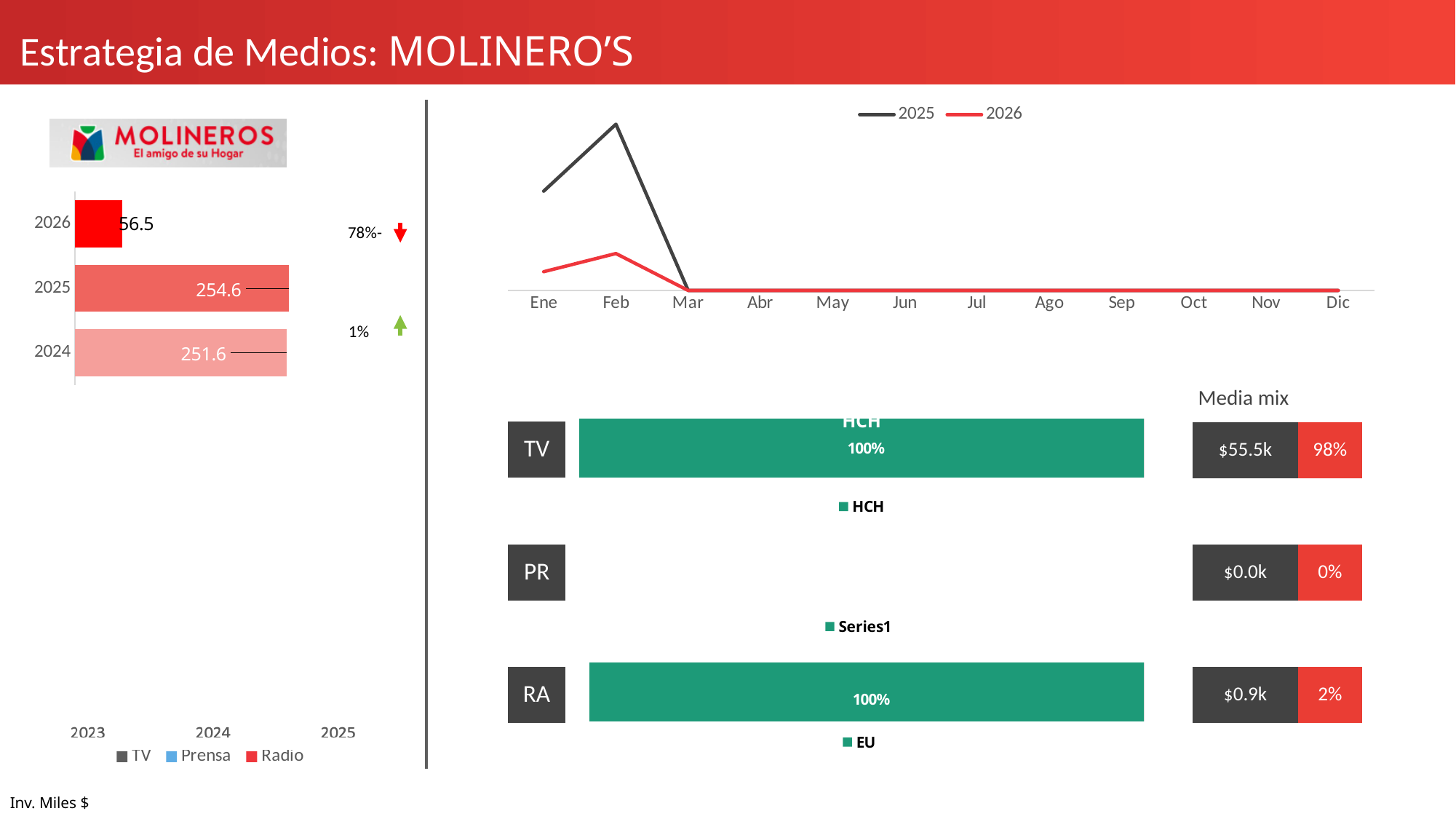
In the horizontal bar chart on the left, what is the value for 2024? 251.6 In the line chart at the top right, how many series does the legend list? 2 In the Media mix section at the bottom right, what is the amount shown for TV? $55.5k In the horizontal bar chart on the left, which year has the highest value? 2025 In the horizontal bar chart on the left, which year has the lowest value? 2026 In the horizontal bar chart on the left, what is the difference between the 2025 and 2026 values? 198.1 In the line chart at the top right, which series is higher in Feb, 2025 or 2026? 2025 In the Media mix section at the bottom right, what percentage is shown for RA? 2% In the line chart at the top right, how many months are shown on the x axis? 12 In the horizontal bar chart on the left, what is the value for 2026? 56.5 In the horizontal bar chart on the left, how many years are plotted? 3 In the horizontal bar chart on the left, what is the value for 2025? 254.6